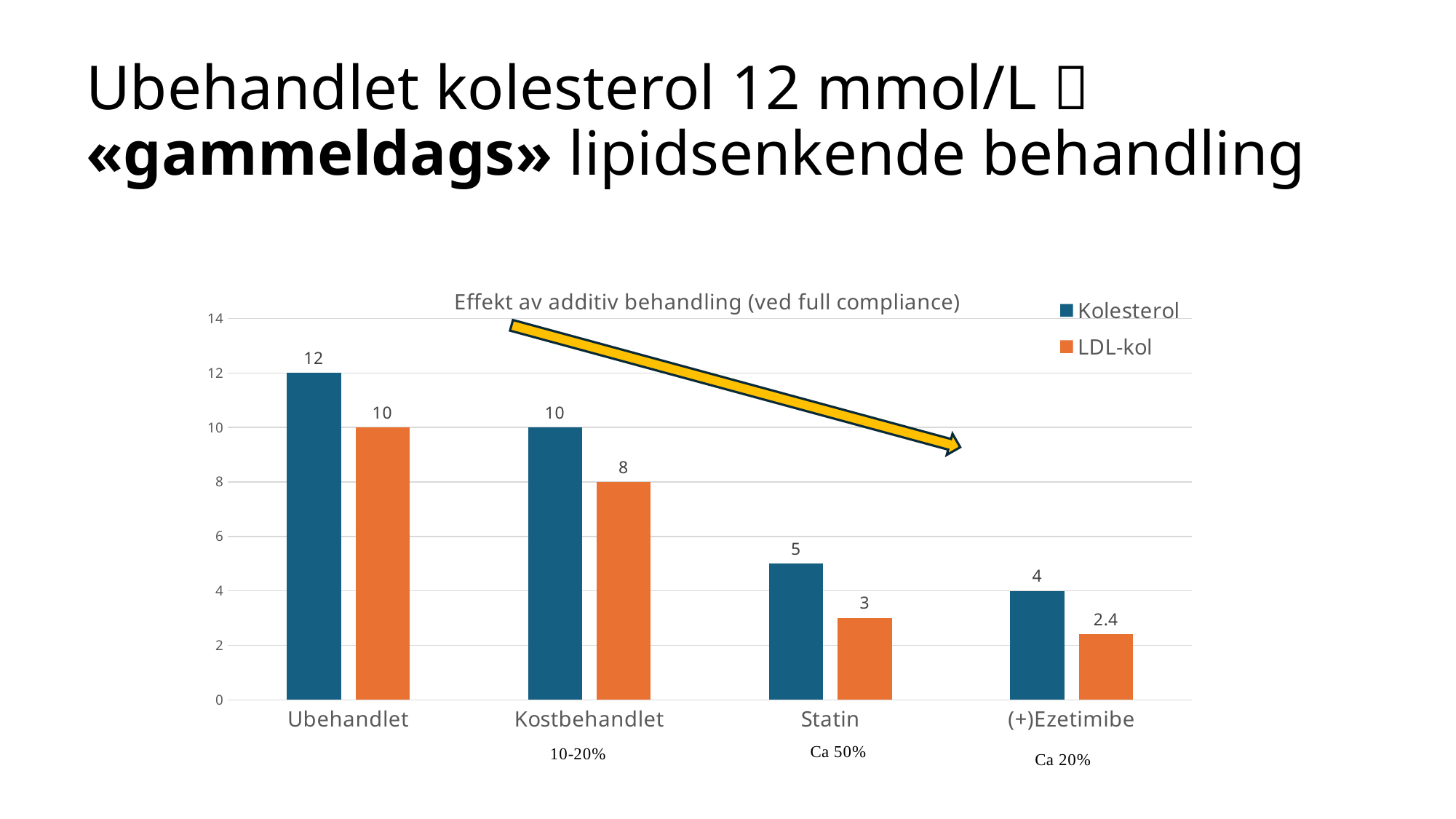
What kind of chart is shown on the slide? Bar chart What is the difference between the Kolesterol values for Kostbehandlet and Statin? 5 How many series does the legend list? 2 Which is larger: the LDL-kol value for Statin or the Kolesterol value for (+)Ezetimibe? Kolesterol value for (+)Ezetimibe Do the Kolesterol values rise or fall from left to right along the x axis? Fall Which category has the lowest LDL-kol value? (+)Ezetimibe What is the LDL-kol value for Kostbehandlet? 8 Which category has the highest Kolesterol value? Ubehandlet What is the Kolesterol value for Ubehandlet? 12 How many categories are shown on the x axis? 4 What is the LDL-kol value for (+)Ezetimibe? 2.4 What is the Kolesterol value for Statin? 5